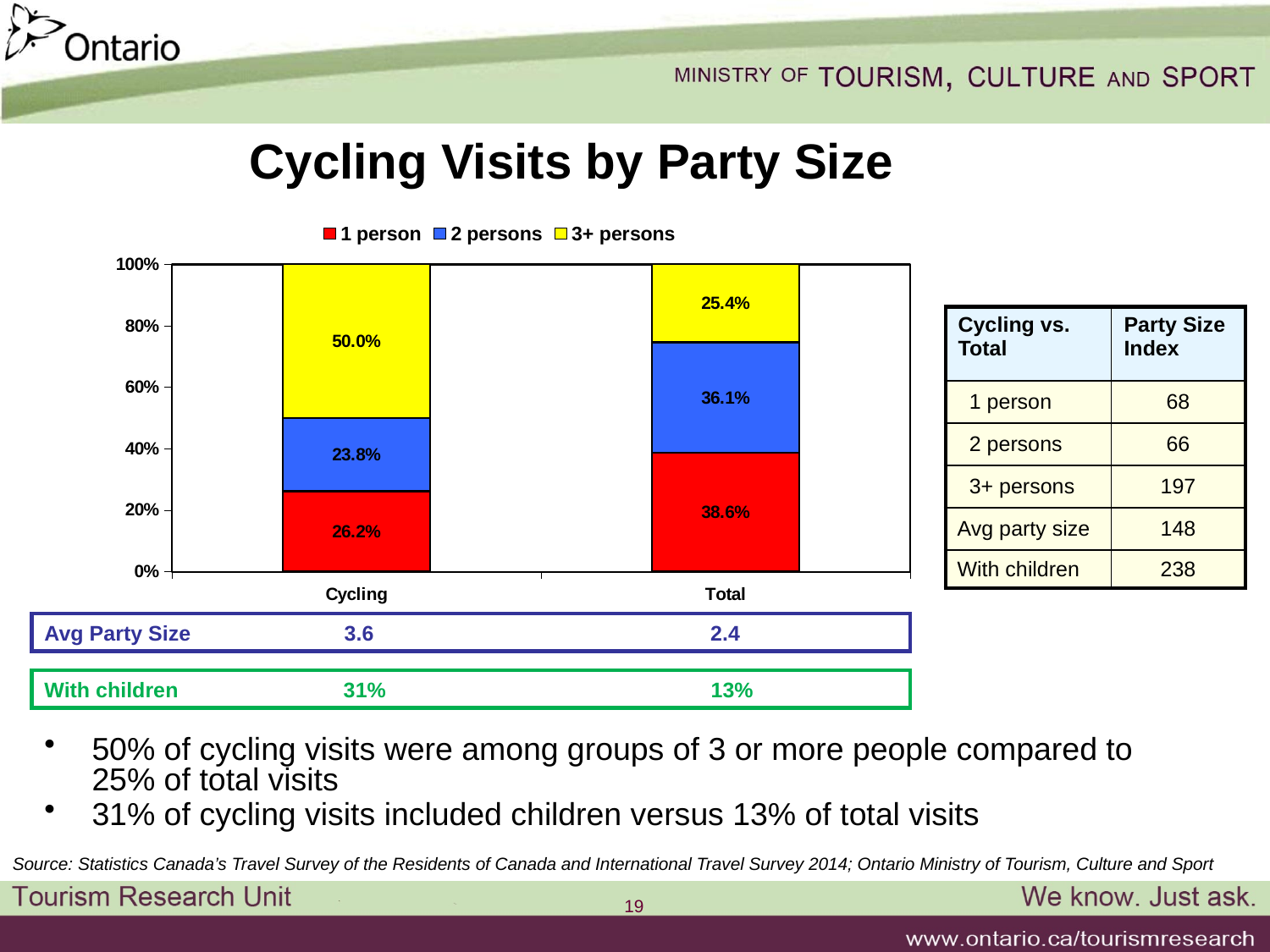
What is the difference between the 3+ persons share for Cycling and for Total? 24.6 percentage points What percentage of Total visits were by 3+ persons? 25.4% How many categories are shown on the x axis? 2 What percentage of Cycling visits were by 2 persons? 23.8% What percentage of Cycling visits were by 3+ persons? 50.0% How many series does the legend list? 3 Which party size segment is the largest for Cycling visits? 3+ persons What percentage of Total visits were by 1 person? 38.6% Which party size segment is the smallest for Total visits? 3+ persons Which colour represents the 1 person series in the chart? Red Which is larger: the 2 persons share for Cycling or for Total? Total What kind of chart is shown on the slide? Stacked bar chart